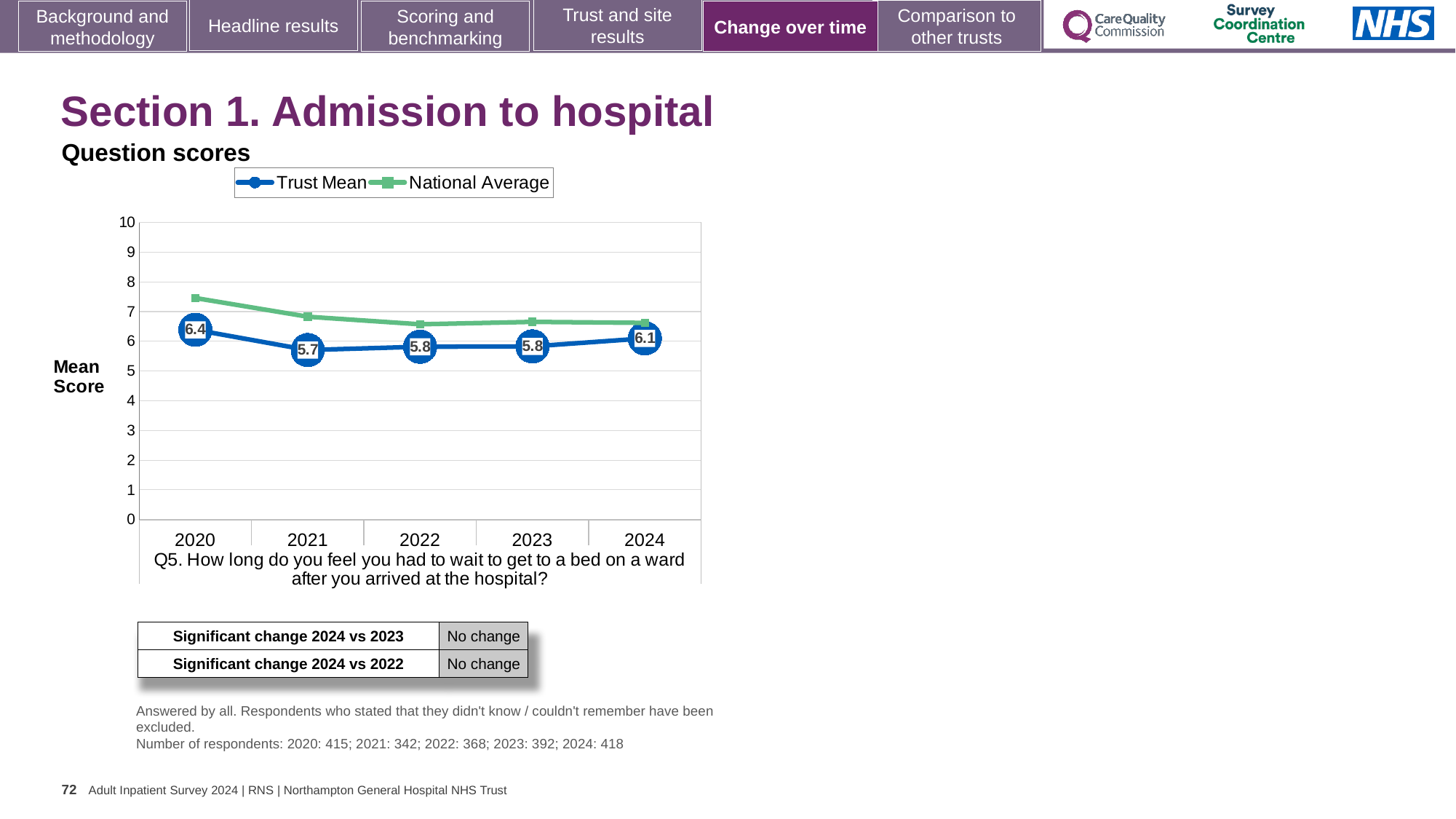
What kind of chart is shown on the slide? Line chart What is the Trust Mean score for 2020? 6.4 Which is larger, the Trust Mean score for 2024 or for 2023? 2024 How many years are plotted on the x axis? 5 In which year is the Trust Mean score lowest? 2021 In which year is the Trust Mean score highest? 2020 How many series does the legend list? 2 Is the National Average value for 2021 greater or less than 6? greater Is the National Average value for 2020 greater or less than 7? greater What is the difference between the Trust Mean scores for 2020 and 2021? 0.7 What is the Trust Mean score for 2024? 6.1 What is the Trust Mean score for 2021? 5.7